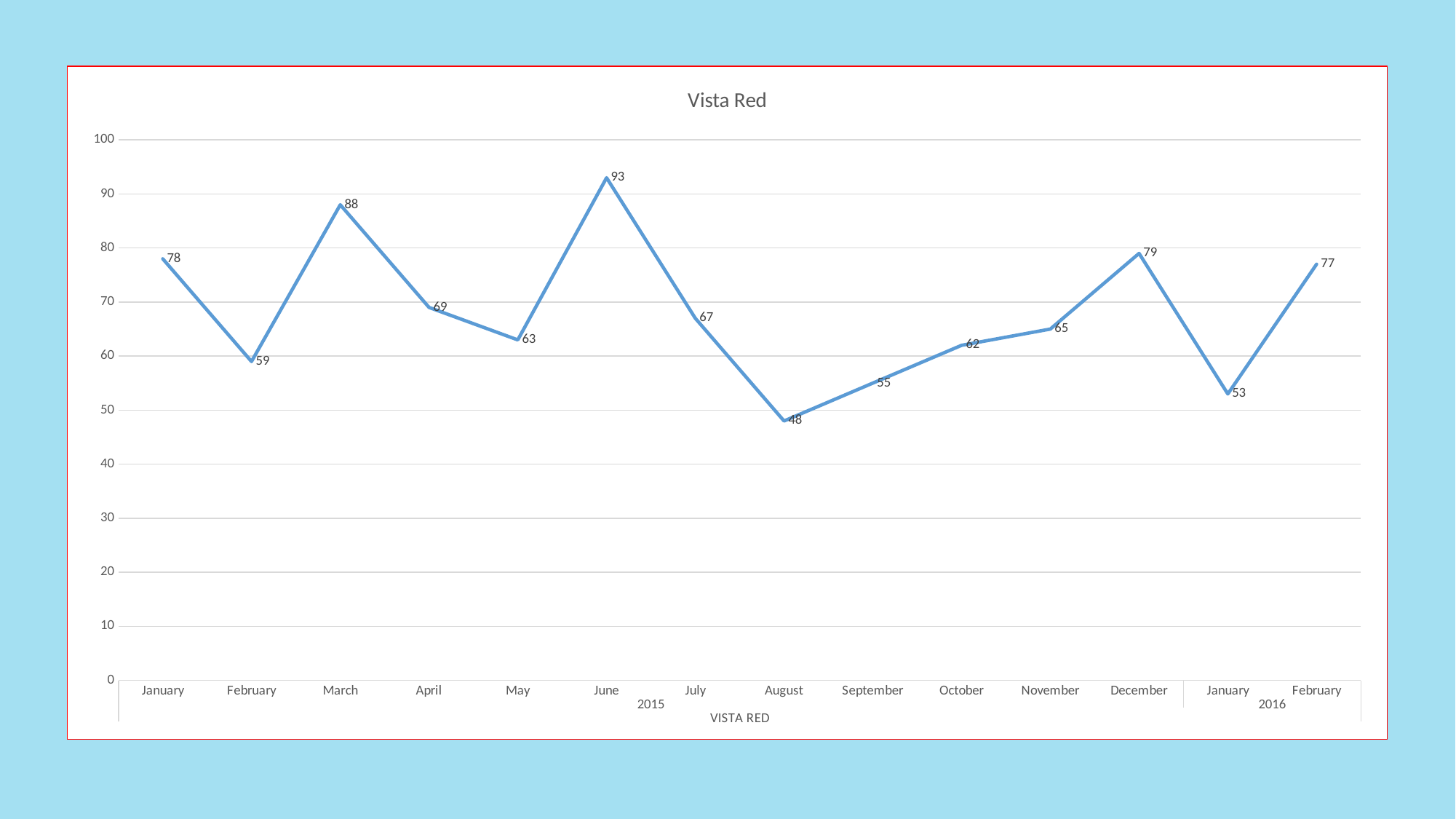
Do the values rise or fall from August 2015 to December 2015? rise What is the value for February 2016? 77 What is the difference between the values for March 2015 and February 2015? 29 What is the title of the chart? Vista Red Which month has the highest value? June 2015 What kind of chart is shown? line chart Which is larger, the value for December 2015 or the value for January 2016? December 2015 Which month has the lowest value? August 2015 What is the value for August 2015? 48 How many data points are plotted on the chart? 14 What is the value for June 2015? 93 Is the value for September 2015 greater or less than 60? less